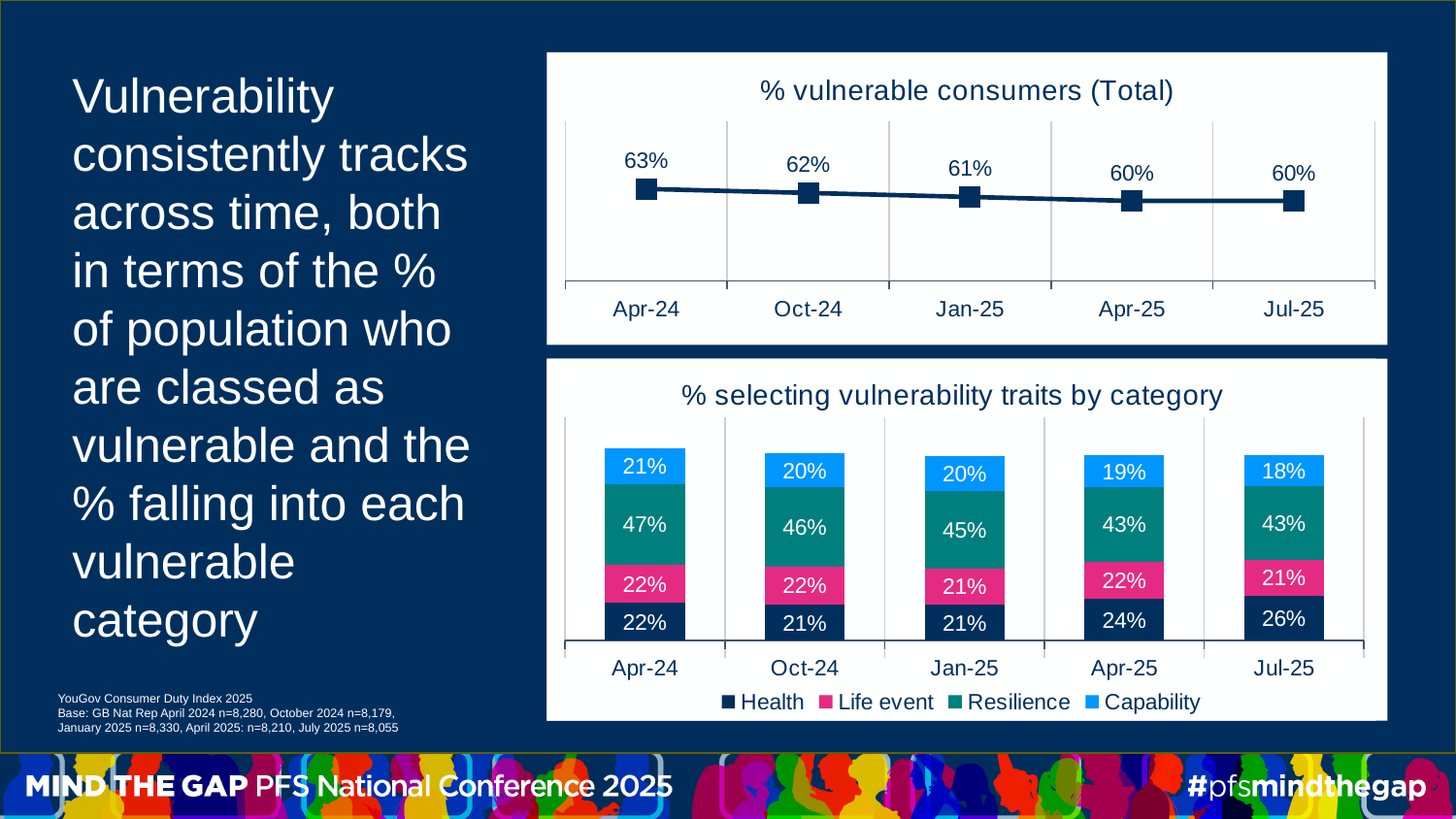
In the '% selecting vulnerability traits by category' chart, what is the total of the stacked bar for Jul-25? 108% In the '% selecting vulnerability traits by category' chart, what is the Resilience value for Apr-24? 47% In the '% selecting vulnerability traits by category' chart, which period has the lowest Capability value? Jul-25 In the '% vulnerable consumers (Total)' chart, which period has the highest value? Apr-24 In the '% vulnerable consumers (Total)' chart, what is the difference between the Apr-24 and Jan-25 values? 2 percentage points In the '% selecting vulnerability traits by category' chart, what is the Health value for Jul-25? 26% In the '% selecting vulnerability traits by category' chart, how many series does the legend list? 4 In the '% vulnerable consumers (Total)' chart, what is the value for Jul-25? 60% What kind of chart is the '% vulnerable consumers (Total)' chart? line chart In the '% vulnerable consumers (Total)' chart, what is the value for Apr-24? 63% In the '% vulnerable consumers (Total)' chart, do the values rise or fall from Apr-24 to Jul-25? fall In the '% selecting vulnerability traits by category' chart, is the Health value larger for Apr-24 or Jul-25? Jul-25